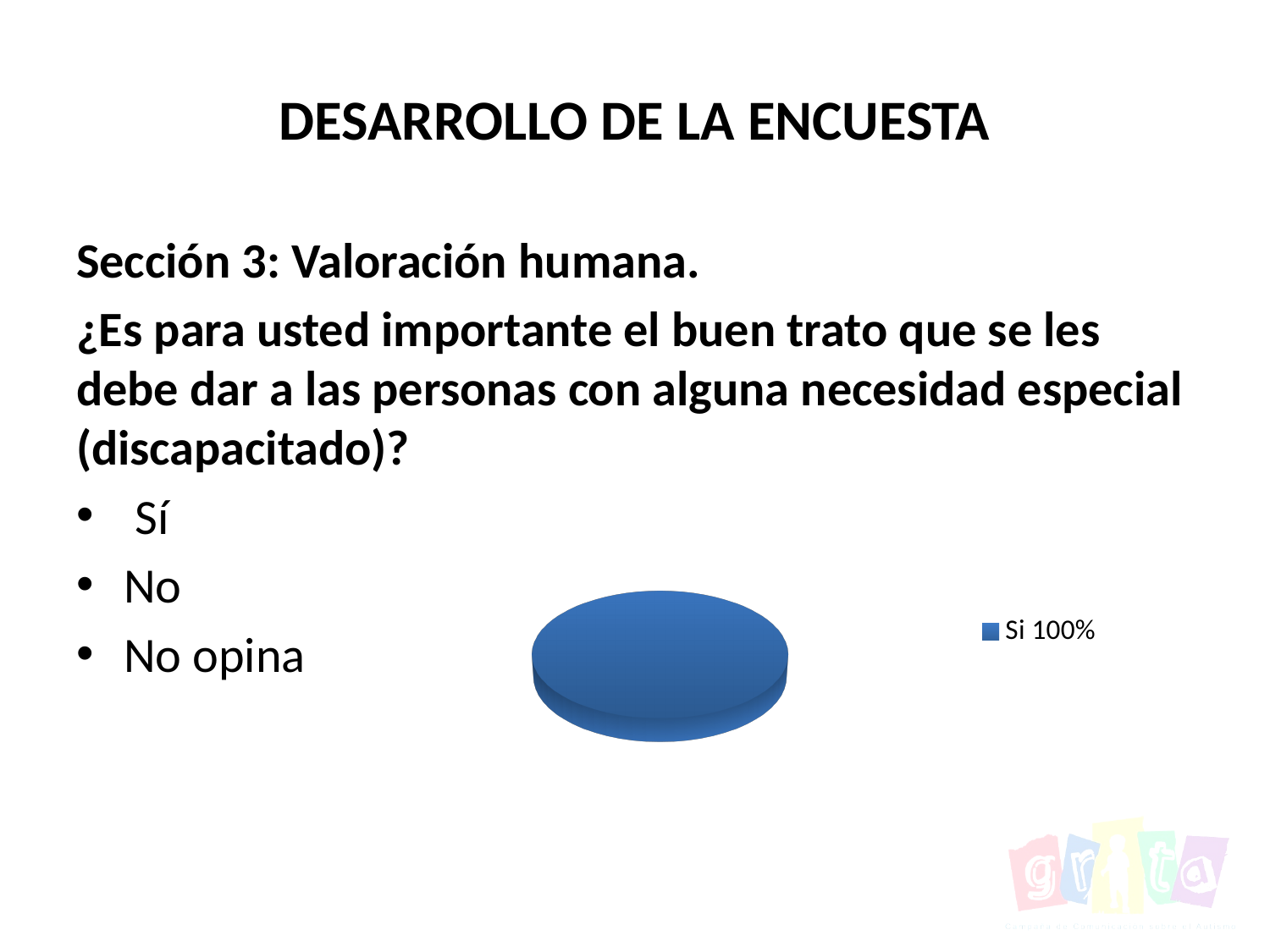
How many entries does the chart legend list? 1 What colour is the "Si" slice of the pie chart? blue Which category makes up the entire pie chart? Si What share of the pie does the "Si" slice represent? 100% How many slices does the pie chart have? 1 What kind of chart is shown on the slide? pie chart What is the label of the only legend entry in the chart? Si 100%